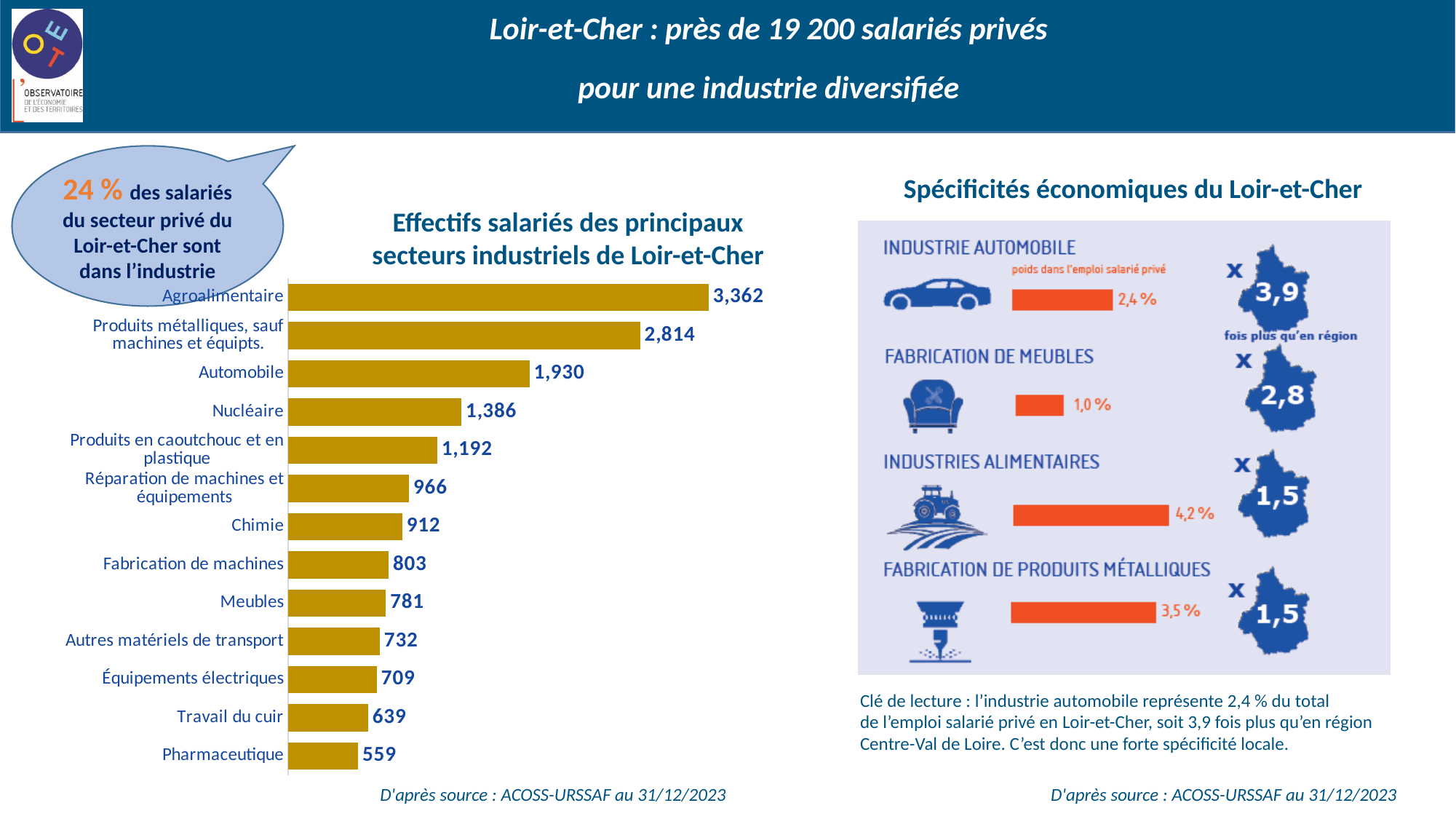
What is the difference between the values for Agroalimentaire and Produits métalliques, sauf machines et équipts. in the bar chart? 548 What is the title of the bar chart on the left of the slide? Effectifs salariés des principaux secteurs industriels de Loir-et-Cher What is the difference between the values for Automobile and Nucléaire in the bar chart? 544 Which sector has the lowest value in the bar chart? Pharmaceutique How many sectors are shown in the bar chart? 13 Which is larger in the bar chart: Meubles or Travail du cuir? Meubles What is the value for Chimie in the bar chart? 912 What is the value for Nucléaire in the bar chart? 1,386 What is the value for Agroalimentaire in the chart 'Effectifs salariés des principaux secteurs industriels de Loir-et-Cher'? 3,362 What is the value for Pharmaceutique in the bar chart? 559 What kind of chart is 'Effectifs salariés des principaux secteurs industriels de Loir-et-Cher'? Bar chart Which sector has the highest value in the bar chart? Agroalimentaire